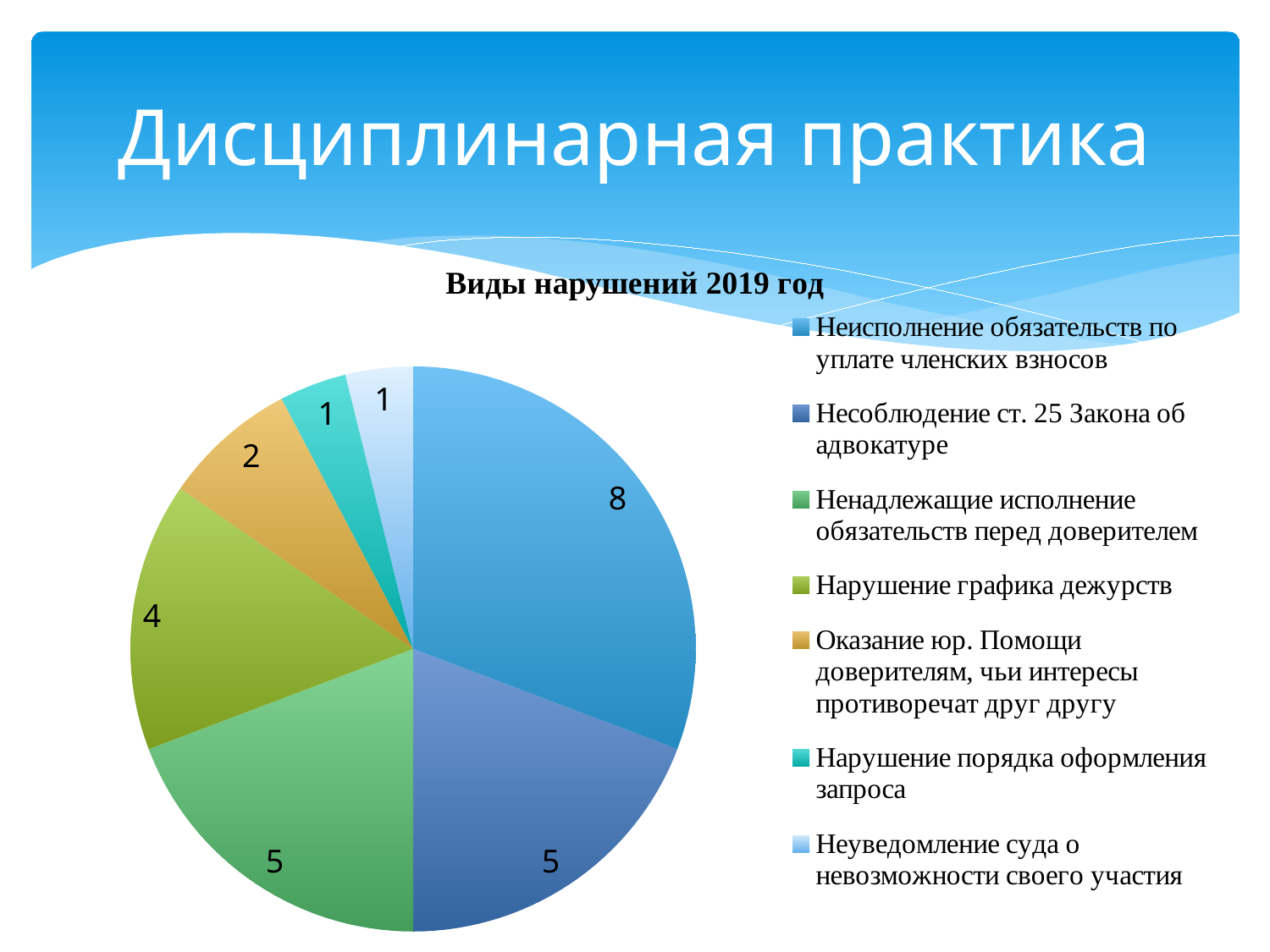
What is the value for 'Нарушение графика дежурств'? 4 What is the value for 'Оказание юр. Помощи доверителям, чьи интересы противоречат друг другу'? 2 How many categories does the legend list? 7 How many slices does the pie chart have? 7 What is the value for 'Неисполнение обязательств по уплате членских взносов'? 8 Which is larger: the value for 'Нарушение графика дежурств' or the value for 'Оказание юр. Помощи доверителям, чьи интересы противоречат друг другу'? Нарушение графика дежурств Which category has the largest slice? Неисполнение обязательств по уплате членских взносов What is the value for 'Несоблюдение ст. 25 Закона об адвокатуре'? 5 What type of chart is shown on the slide? Pie chart Which categories have the smallest value in the chart? Нарушение порядка оформления запроса and Неуведомление суда о невозможности своего участия What is the title of the chart? Виды нарушений 2019 год What is the difference between the value for 'Неисполнение обязательств по уплате членских взносов' and the value for 'Нарушение графика дежурств'? 4